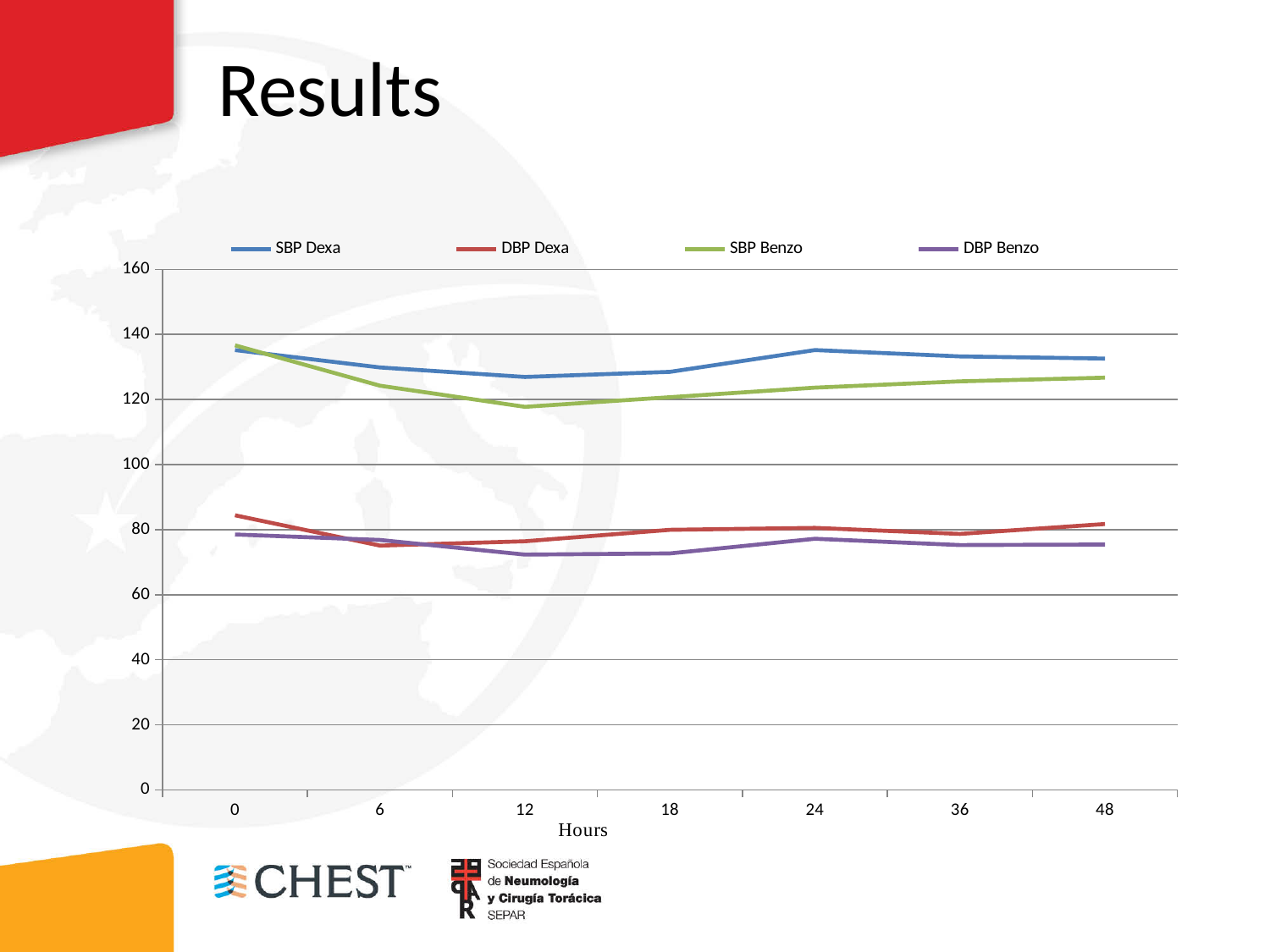
Is the value for SBP Benzo at 12 hours greater or less than 100? greater What kind of chart is shown on the slide? line chart At 48 hours, which is higher: DBP Dexa or DBP Benzo? DBP Dexa At 24 hours, which is higher: SBP Dexa or SBP Benzo? SBP Dexa At which hour does SBP Benzo reach its lowest value? 12 What is the title of the x axis? Hours How many series does the legend list? 4 Which series is drawn in green? SBP Benzo Does SBP Benzo rise or fall between 0 and 12 hours? fall Is the value for DBP Benzo at 12 hours greater or less than 80? less Is the value for SBP Dexa at 0 hours greater or less than 120? greater How many time points are plotted along the x axis? 7